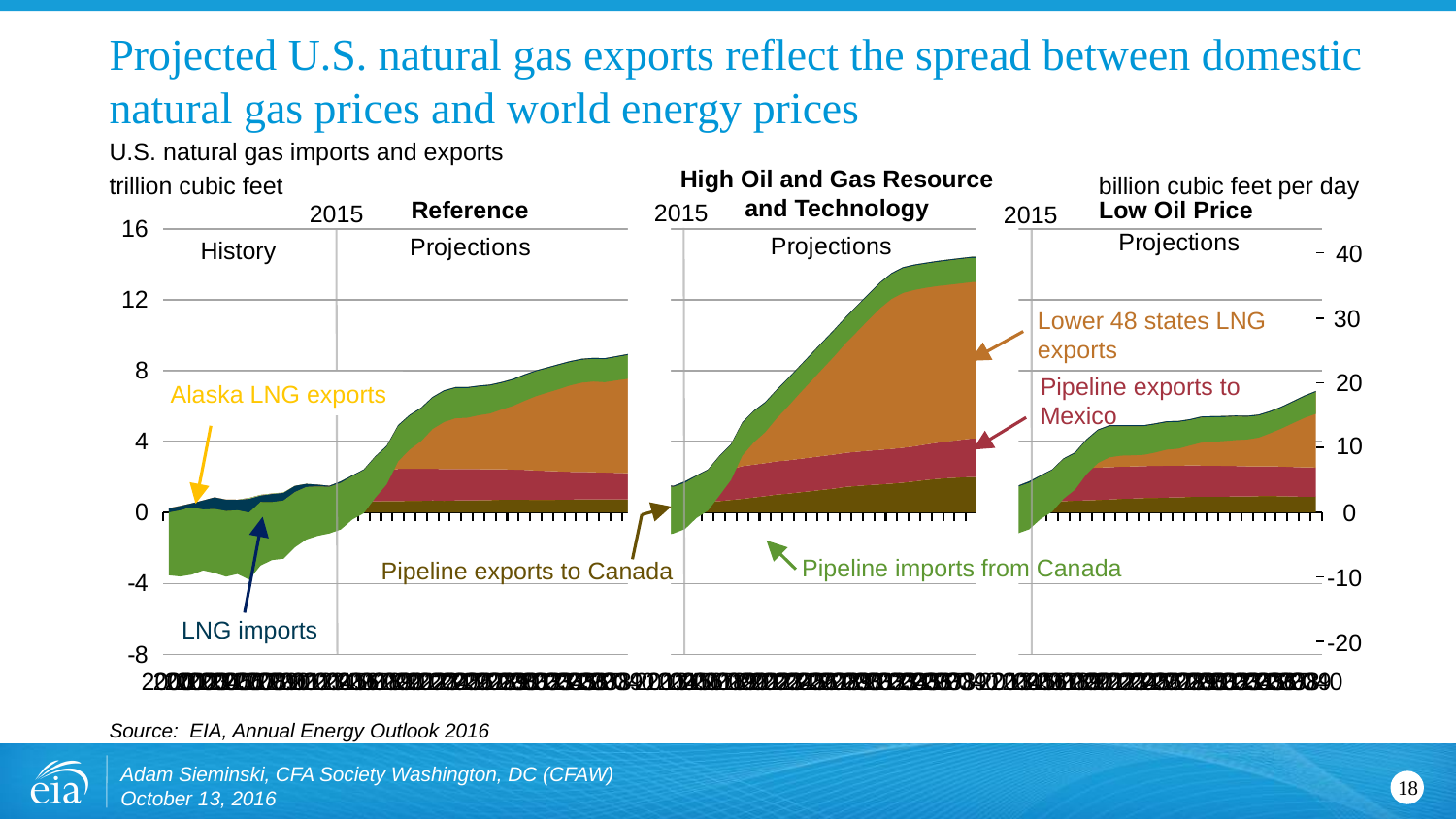
In the High Oil and Gas Resource and Technology chart, is the total of the stacked exports at the end of the projection period greater or less than 12 trillion cubic feet? greater Which scenario shows the lowest total natural gas exports at the end of the projection period? Low Oil Price Which series is plotted below zero in the History portion of the Reference chart, labeled in green? Pipeline imports from Canada What kind of chart is used for the Reference scenario on this slide? stacked area chart In the Low Oil Price chart, is the total of the stacked exports at the end of the projection period greater or less than 4 trillion cubic feet? greater How many labeled series (import/export categories) are identified across the charts? 6 What is the unit of the right vertical axis? billion cubic feet per day Which scenario shows the highest total natural gas exports at the end of the projection period? High Oil and Gas Resource and Technology How many scenario panels are shown on the slide? 3 What is the unit of the left vertical axis? trillion cubic feet In the Reference chart, is the total of the stacked exports at the end of the projection period greater or less than 8 trillion cubic feet? greater In the Reference chart, do total exports rise or fall over the projection period? rise